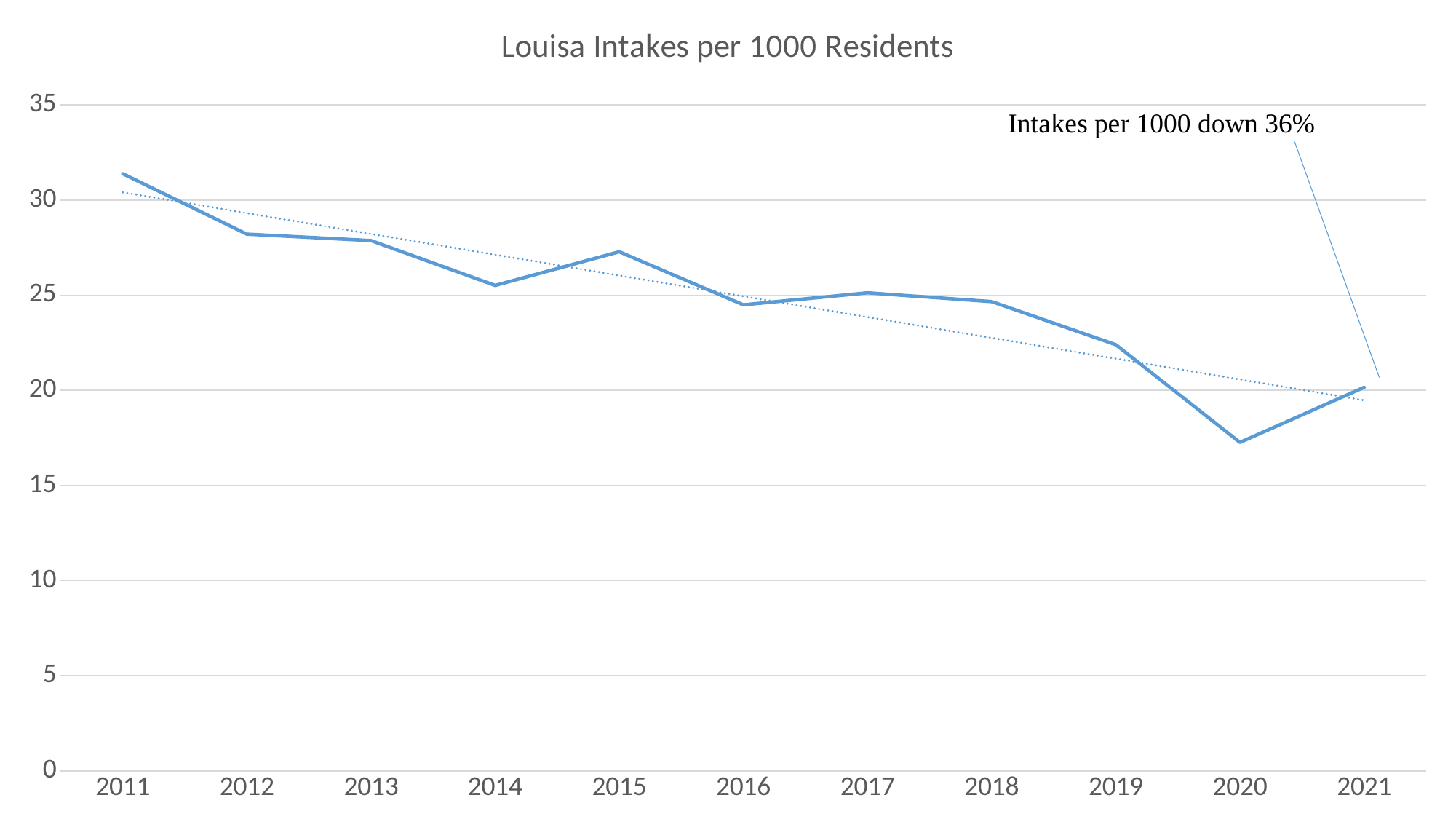
According to the annotation on the chart, by what percentage are intakes per 1000 down? 36% Do intakes per 1000 residents generally rise or fall from 2011 to 2021? fall How many years are plotted along the x axis? 11 Is the value for 2011 greater or less than 30? greater Which year has the lowest intakes per 1000 residents? 2020 Is the value for 2020 greater or less than 20? less Is the value for 2016 greater or less than 25? less What kind of chart is shown on the slide? line chart Which year has the highest intakes per 1000 residents? 2011 Which year has the larger value, 2019 or 2020? 2019 What is the title of the chart? Louisa Intakes per 1000 Residents Which year has the larger value, 2014 or 2015? 2015